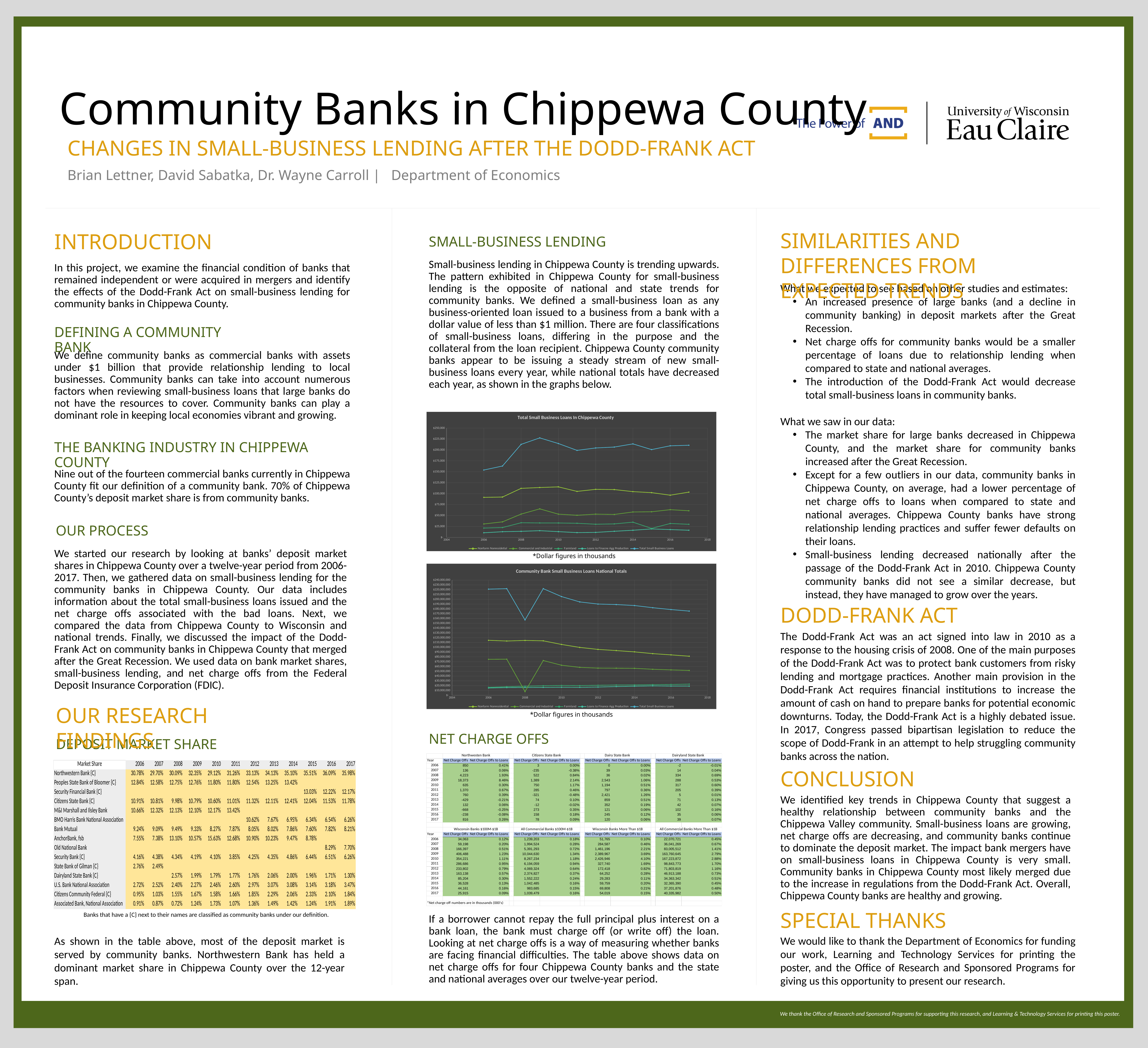
In the 'Community Bank Small Business Loans National Totals' chart, is the Total Small Business Loans value for 2017 greater or less than $200,000,000? less In the 'Community Bank Small Business Loans National Totals' chart, does the Total Small Business Loans line generally rise or fall from 2009 to 2017? fall What is the title of the upper line chart in the middle column? Total Small Business Loans In Chippewa County What kind of chart is the 'Community Bank Small Business Loans National Totals' chart? line chart In the 'Total Small Business Loans In Chippewa County' chart, does the Total Small Business Loans line generally rise or fall from 2006 to 2017? rise How many series does the legend of the 'Total Small Business Loans In Chippewa County' chart list? 5 In the 'Total Small Business Loans In Chippewa County' chart, is the Total Small Business Loans value for 2017 greater or less than $150,000? greater In the 'Total Small Business Loans In Chippewa County' chart, which series has the highest values across the period? Total Small Business Loans What kind of chart is the 'Total Small Business Loans In Chippewa County' chart? line chart In the 'Total Small Business Loans In Chippewa County' chart, which is larger in 2017: Nonfarm Nonresidential or Commercial and Industrial? Nonfarm Nonresidential In the 'Total Small Business Loans In Chippewa County' chart, is the Total Small Business Loans value for 2006 greater or less than $175,000? less How many series does the legend of the 'Community Bank Small Business Loans National Totals' chart list? 5